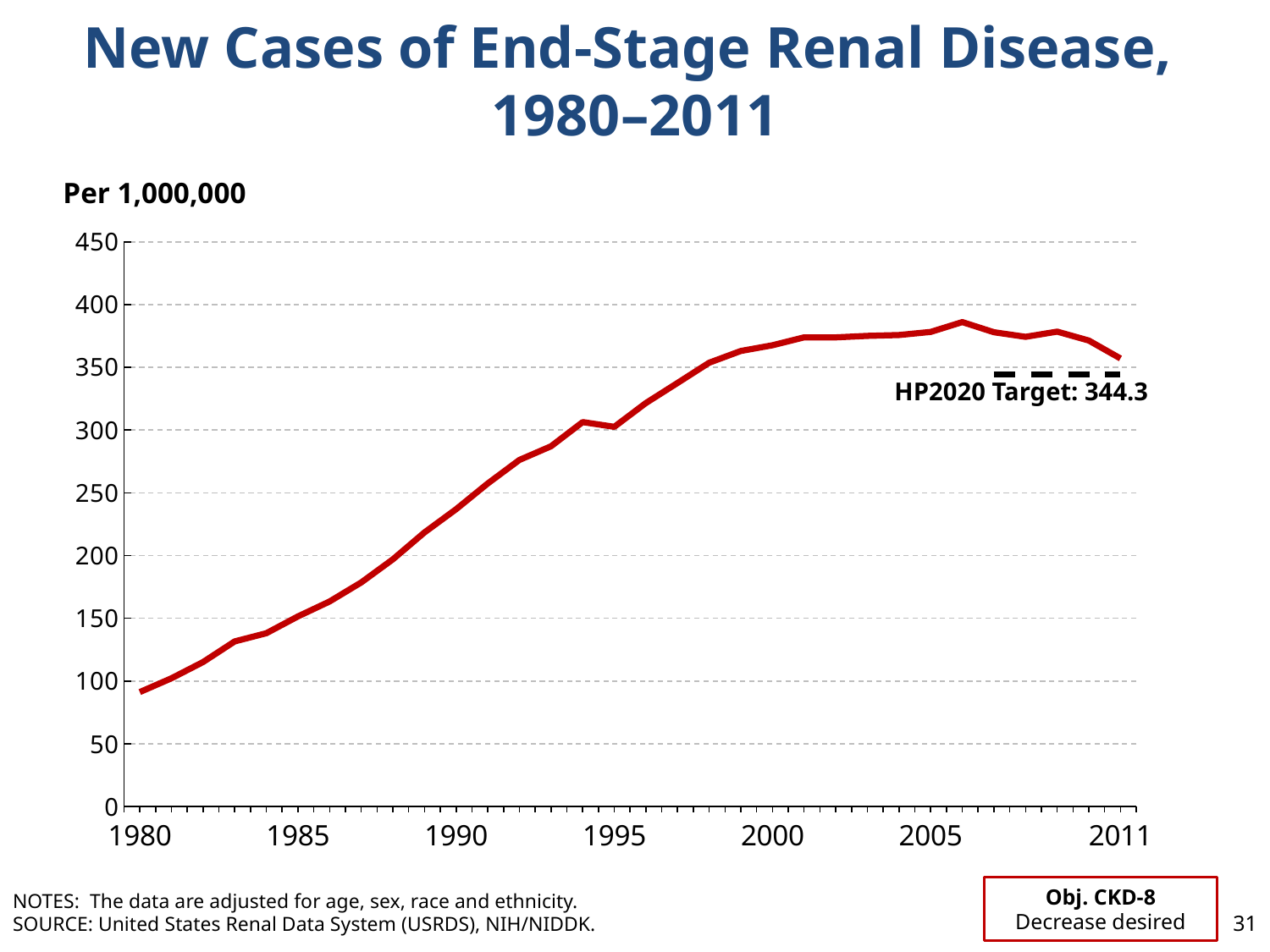
Is the value for 1980 greater or less than 100? less Which year has the higher value, 1990 or 2000? 2000 In which year is the rate of new cases lowest? 1980 What kind of chart is shown on the slide? line chart Is the value for 2000 greater or less than 350? greater Is the value for 1985 greater or less than 200? less What is the title of the chart? New Cases of End-Stage Renal Disease, 1980–2011 Does the rate of new cases rise or fall between 1980 and 2000? rise What unit is the y axis measured in, according to the label above the chart? Per 1,000,000 What is the HP2020 target value shown on the chart? 344.3